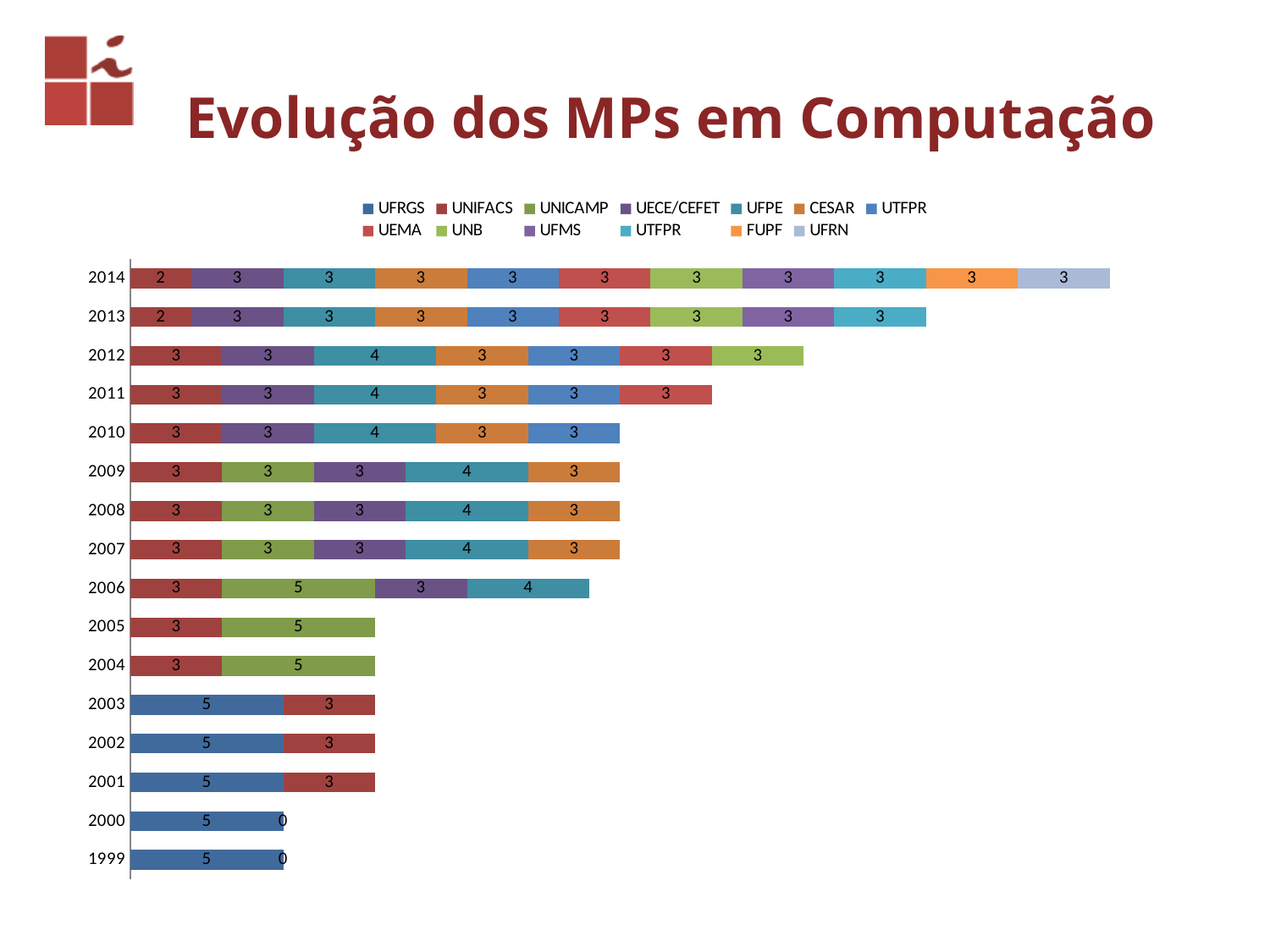
Which year has the longest stacked bar? 2014 What is the total of the stacked bar for 2003? 8 What is the title of the chart? Evolução dos MPs em Computação Which year has a longer stacked bar, 2006 or 2005? 2006 What is the total of the stacked bar for 2012? 22 What is the total of the stacked bar for 2014? 32 What kind of chart is shown on the slide? Stacked bar chart What is the difference between the total for 2014 and the total for 2013? 6 What is the value for UFRGS in 2001? 5 How many years (categories) are shown on the vertical axis? 16 How many series does the legend list? 13